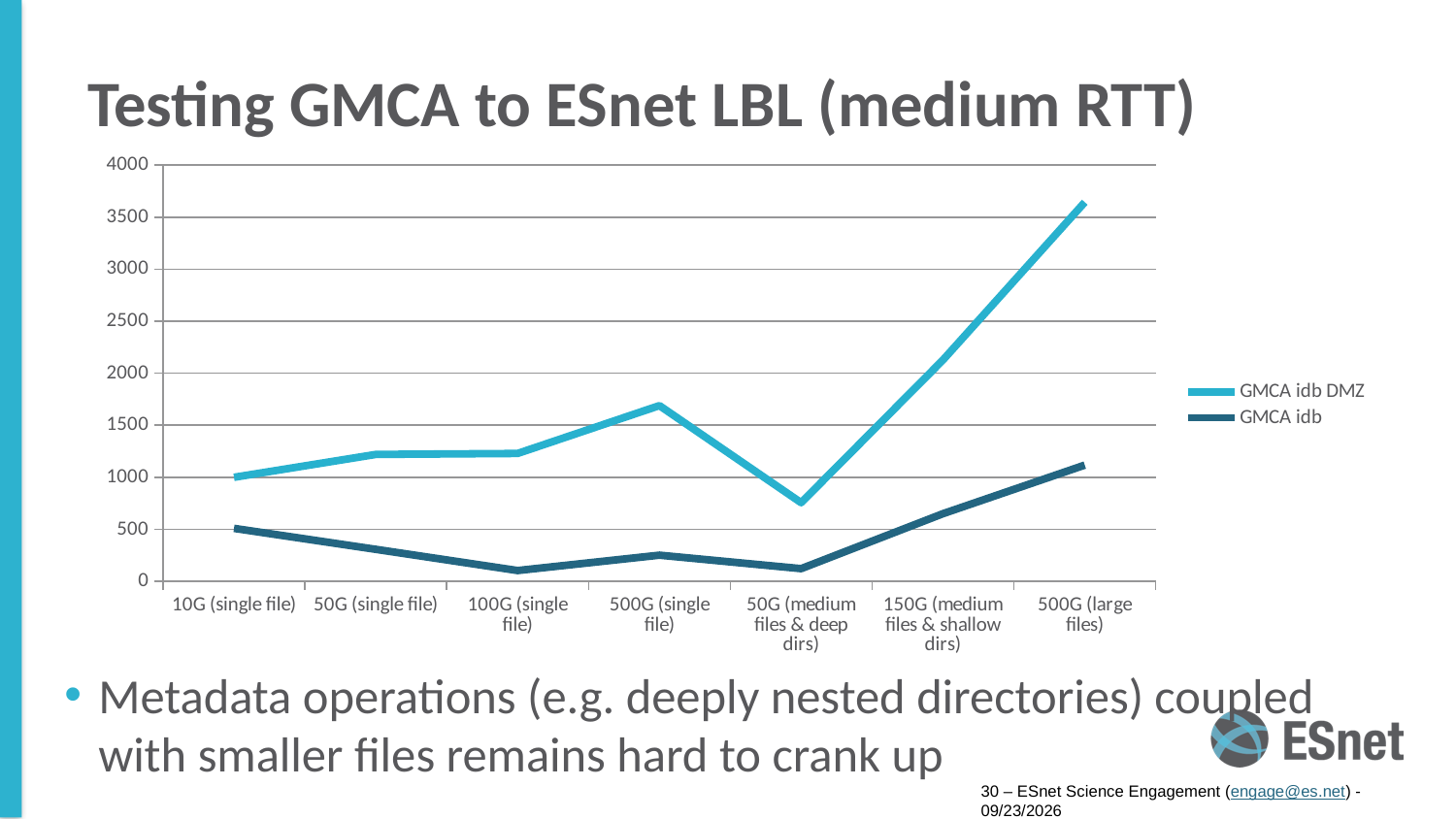
Is the GMCA idb value for 500G (large files) greater or less than 1000? greater Is the GMCA idb DMZ value for 500G (large files) greater or less than 3500? greater For which category is the GMCA idb DMZ series lowest? 50G (medium files & deep dirs) Which series are listed in the legend? GMCA idb DMZ and GMCA idb What kind of chart is shown on the slide? line chart How many categories are shown on the x axis? 7 How many series does the legend list? 2 Is the GMCA idb DMZ value for 50G (medium files & deep dirs) greater or less than 1000? less For which category is the GMCA idb series highest? 500G (large files) For which category is the GMCA idb DMZ series highest? 500G (large files) At 500G (single file), which series has the higher value, GMCA idb DMZ or GMCA idb? GMCA idb DMZ